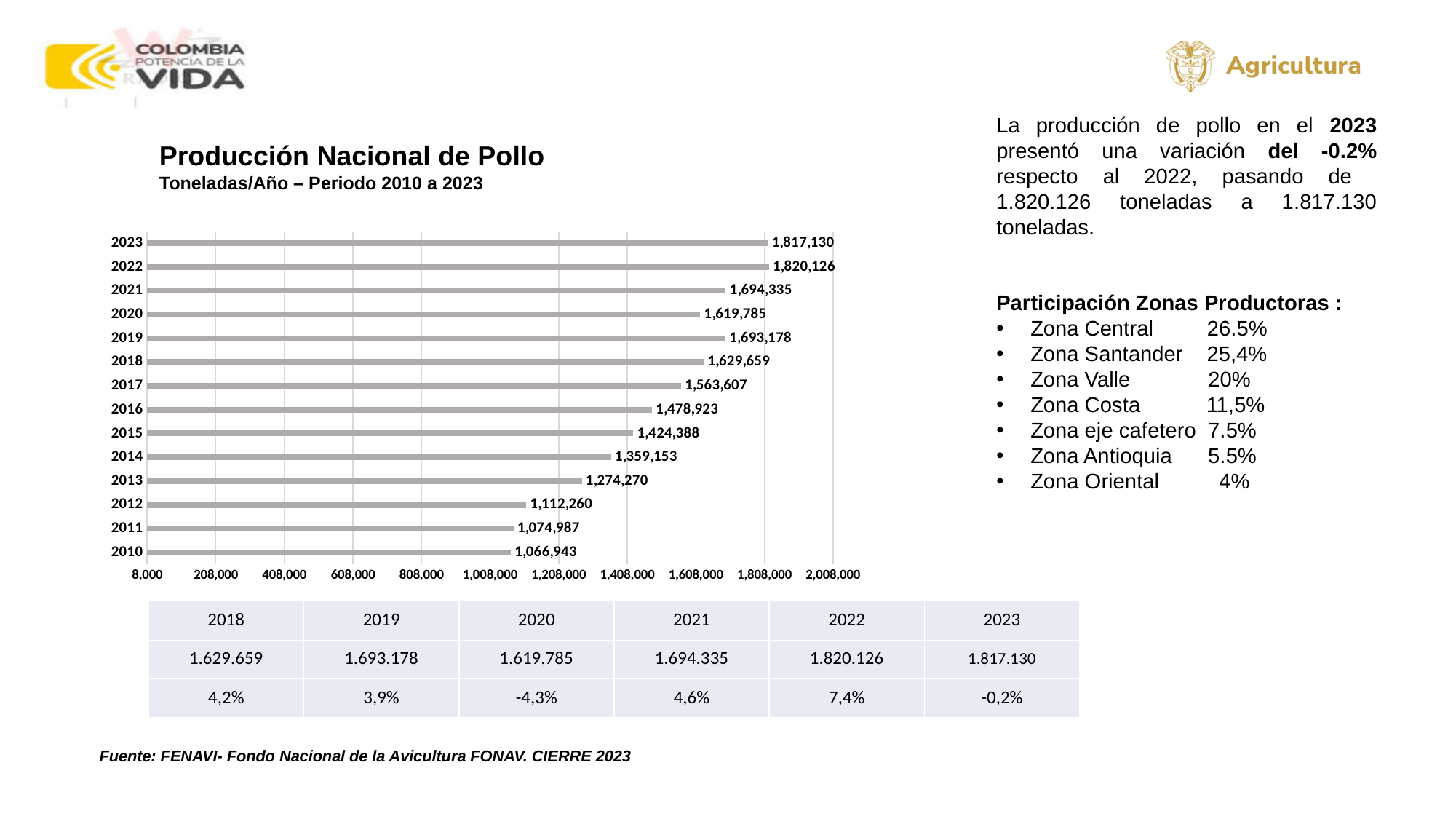
What is the difference between the values for 2021 and 2020 in the Producción Nacional de Pollo chart? 74,550 Which year has the lowest value in the Producción Nacional de Pollo chart? 2010 What is the value for 2023 in the Producción Nacional de Pollo chart? 1,817,130 How many years are shown in the Producción Nacional de Pollo chart? 14 What is the difference between the values for 2022 and 2023 in the Producción Nacional de Pollo chart? 2,996 Is the value for 2017 in the Producción Nacional de Pollo chart greater or less than 1,408,000? greater What is the value for 2015 in the Producción Nacional de Pollo chart? 1,424,388 What is the subtitle shown under the title of the Producción Nacional de Pollo chart? Toneladas/Año – Periodo 2010 a 2023 What is the value for 2010 in the Producción Nacional de Pollo chart? 1,066,943 Which is larger in the Producción Nacional de Pollo chart, the value for 2019 or the value for 2020? 2019 What kind of chart is the Producción Nacional de Pollo chart? bar chart Which year has the highest value in the Producción Nacional de Pollo chart? 2022